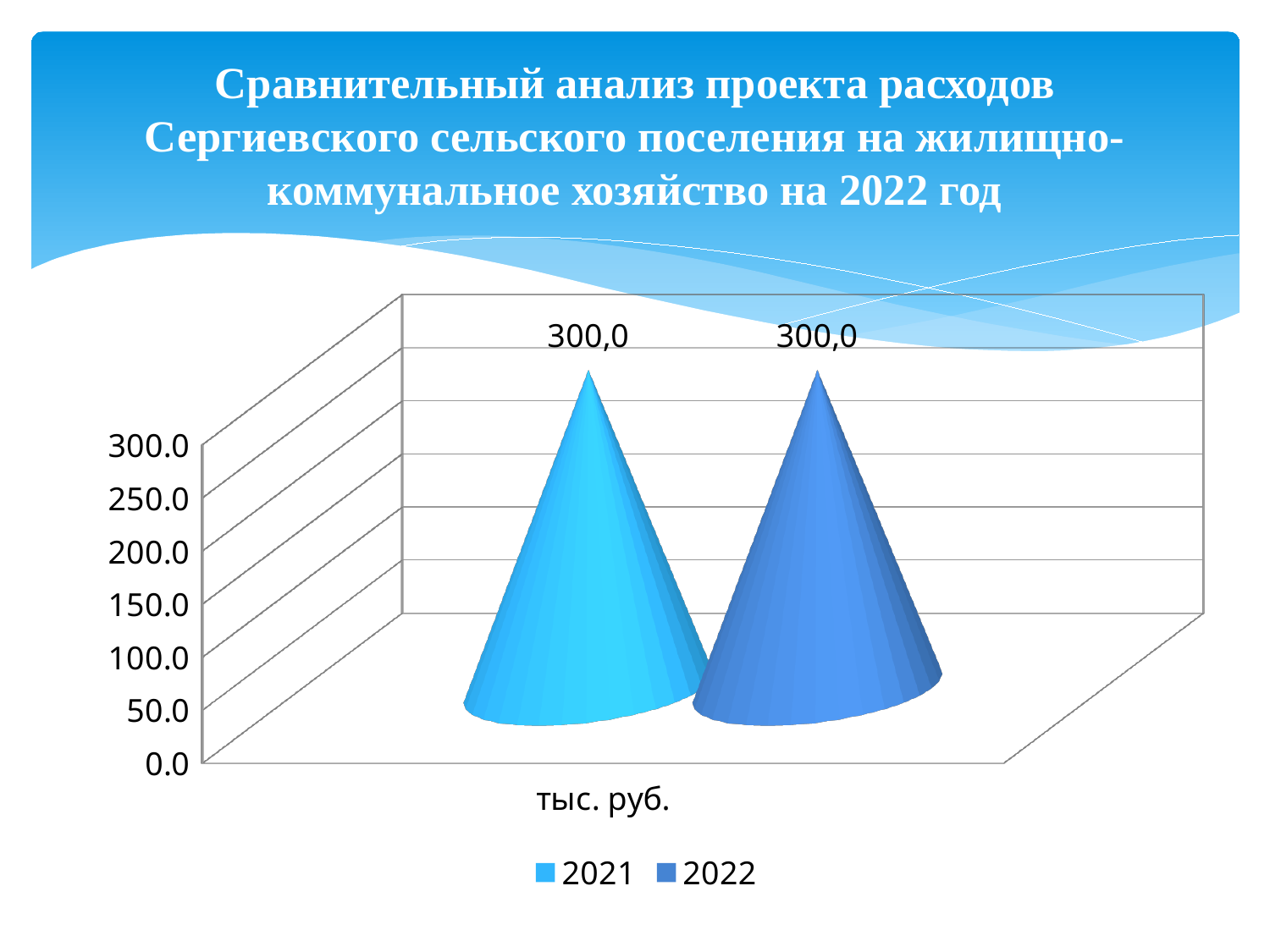
Which series are listed in the legend? 2021 and 2022 What is the value for the 2021 series? 300,0 Is the value for 2021 greater or less than 250? greater How many categories are shown on the x axis? 1 What kind of chart is shown on the slide? bar chart What is the highest value shown on the vertical axis? 300.0 Is the value for 2022 greater or less than 200? greater What is the difference between the 2022 value and the 2021 value? 0,0 How many series does the legend list? 2 What is the value for the 2022 series? 300,0 What label is shown on the x axis under the bars? тыс. руб.